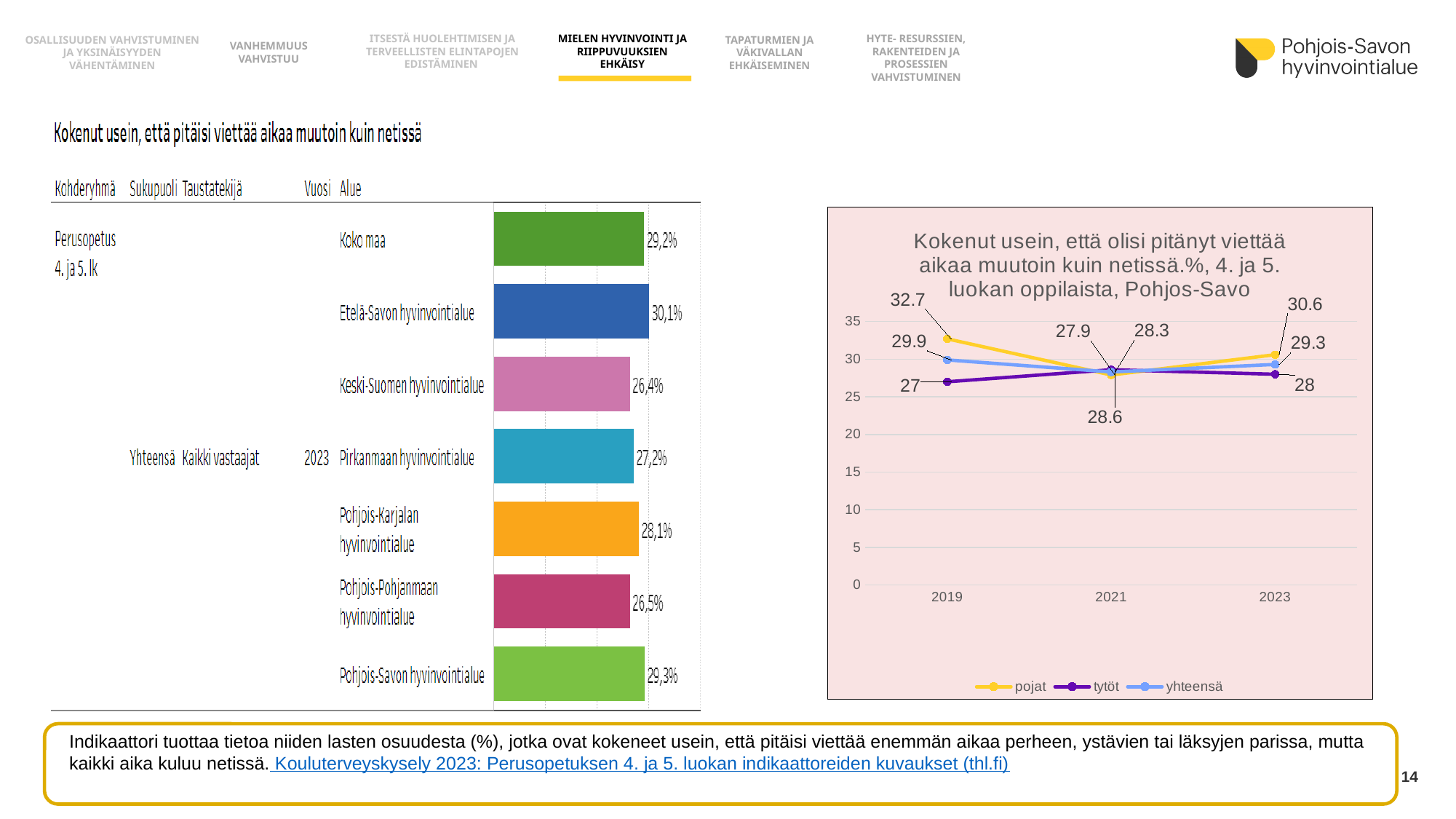
In the left bar chart, which region has the lowest value? Keski-Suomen hyvinvointialue In the right line chart, what is the difference between pojat and yhteensä in 2023? 1.3 In the right line chart, what is the value for pojat in 2019? 32.7 What type of chart is the chart on the left? bar chart In the right line chart, which is larger in 2023: pojat or tytöt? pojat In the left bar chart, which region has the highest value? Etelä-Savon hyvinvointialue In the left bar chart, what is the value for Etelä-Savon hyvinvointialue? 30,1% In the left bar chart, what is the value for Pohjois-Savon hyvinvointialue? 29,3% In the right line chart, what is the value for tytöt in 2021? 28.6 In the left bar chart, how many regions are shown? 7 In the right line chart, how many series does the legend list? 3 In the left bar chart, what is the difference between Koko maa and Pirkanmaan hyvinvointialue? 2,0%